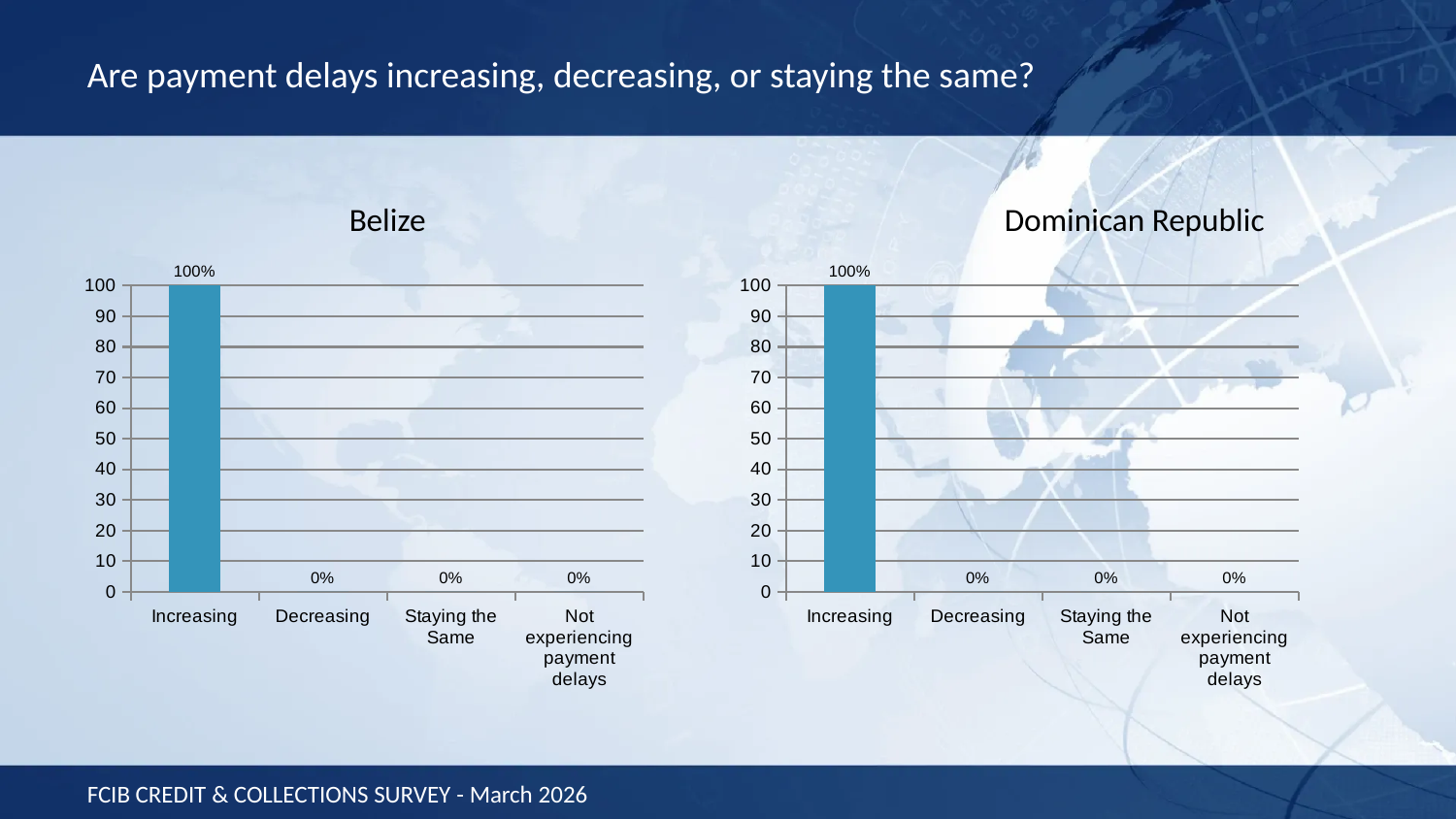
In the Dominican Republic chart, what is the value for Decreasing? 0% In the Belize chart, what is the value for Increasing? 100% In the Dominican Republic chart, what is the value for Staying the Same? 0% What is the title of the chart on the right side of the slide? Dominican Republic In the Belize chart, what is the difference between the values for Increasing and Decreasing? 100% In the Belize chart, which category has the highest value? Increasing How many categories are shown on the x axis of the Belize chart? 4 In the Belize chart, what is the value for Not experiencing payment delays? 0% In the Dominican Republic chart, which category has the highest value? Increasing What is the title of the chart on the left side of the slide? Belize What kind of chart is the Dominican Republic chart? Bar chart In the Dominican Republic chart, which is larger, the value for Increasing or the value for Staying the Same? Increasing